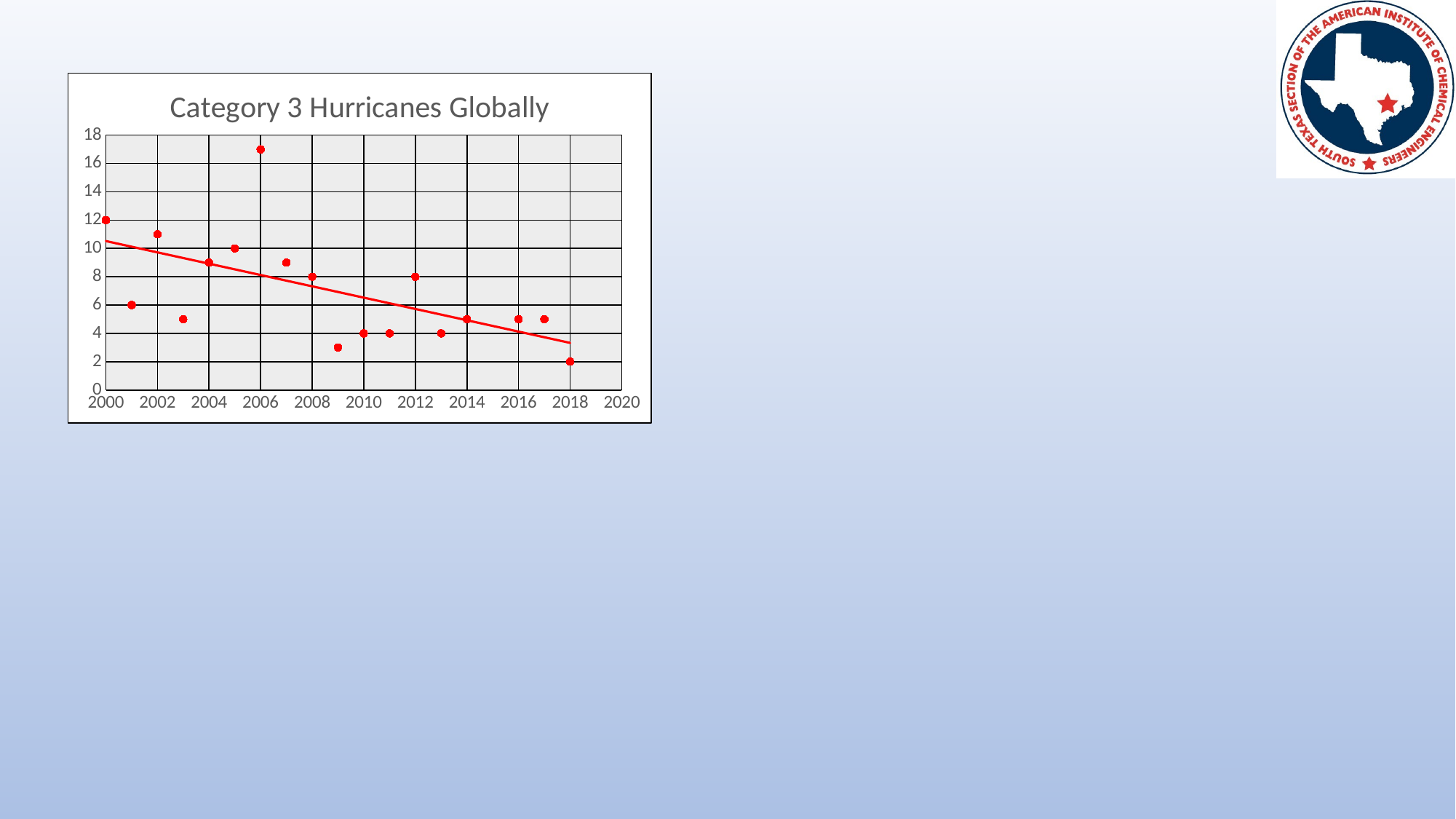
Which year has the lowest number of Category 3 hurricanes? 2018 Which year has the larger value, 2000 or 2001? 2000 Is the value for 2002 greater or less than 10? greater What is the value plotted for the year 2000? 12 What is the value plotted for the year 2005? 10 Which year has the highest number of Category 3 hurricanes? 2006 Does the trend line rise or fall from 2000 to 2018? fall What is the title of the chart? Category 3 Hurricanes Globally What kind of chart is shown on the slide? scatter chart Is the value for 2009 greater or less than 4? less Is the value for 2006 greater or less than 16? greater What is the value plotted for the year 2018? 2